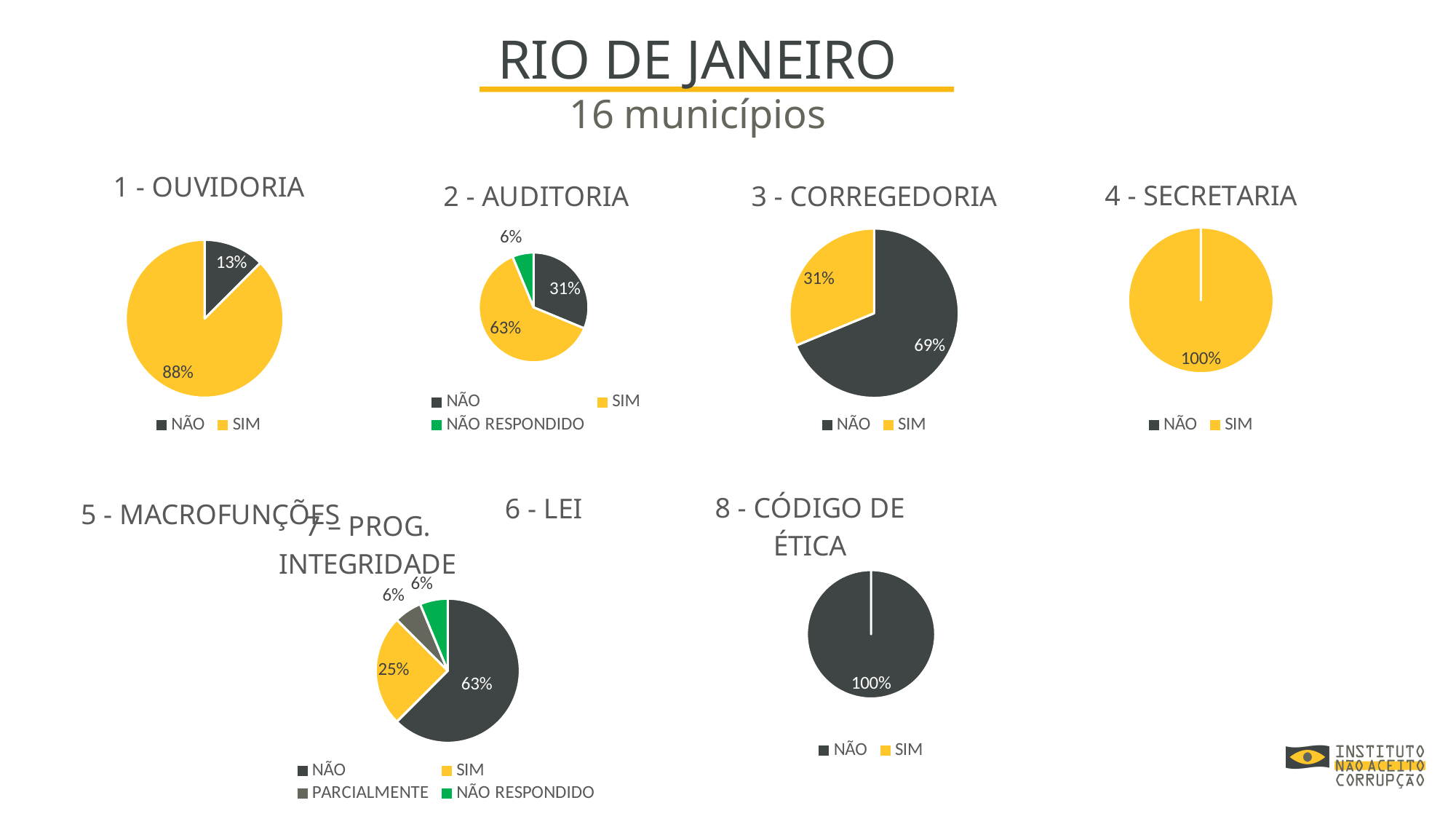
In the 4 - SECRETARIA chart, what percentage is SIM? 100% In the 3 - CORREGEDORIA chart, what is the difference between the NÃO and SIM shares? 38% In the 1 - OUVIDORIA chart, what percentage is NÃO? 13% In the 2 - AUDITORIA chart, what percentage is NÃO RESPONDIDO? 6% In the bottom-left pie chart with four slices (under 7 - PROG. INTEGRIDADE), what percentage is SIM? 25% How many entries does the legend of the bottom-left pie chart (under 7 - PROG. INTEGRIDADE) list? 4 In the 8 - CÓDIGO DE ÉTICA chart, which category accounts for 100%? NÃO In the 2 - AUDITORIA chart, which is larger, NÃO or SIM? SIM What type of chart is used for 1 - OUVIDORIA? Pie chart In the 1 - OUVIDORIA chart, what percentage is SIM? 88% In the 2 - AUDITORIA chart, which category has the largest share? SIM In the 3 - CORREGEDORIA chart, what percentage is NÃO? 69%